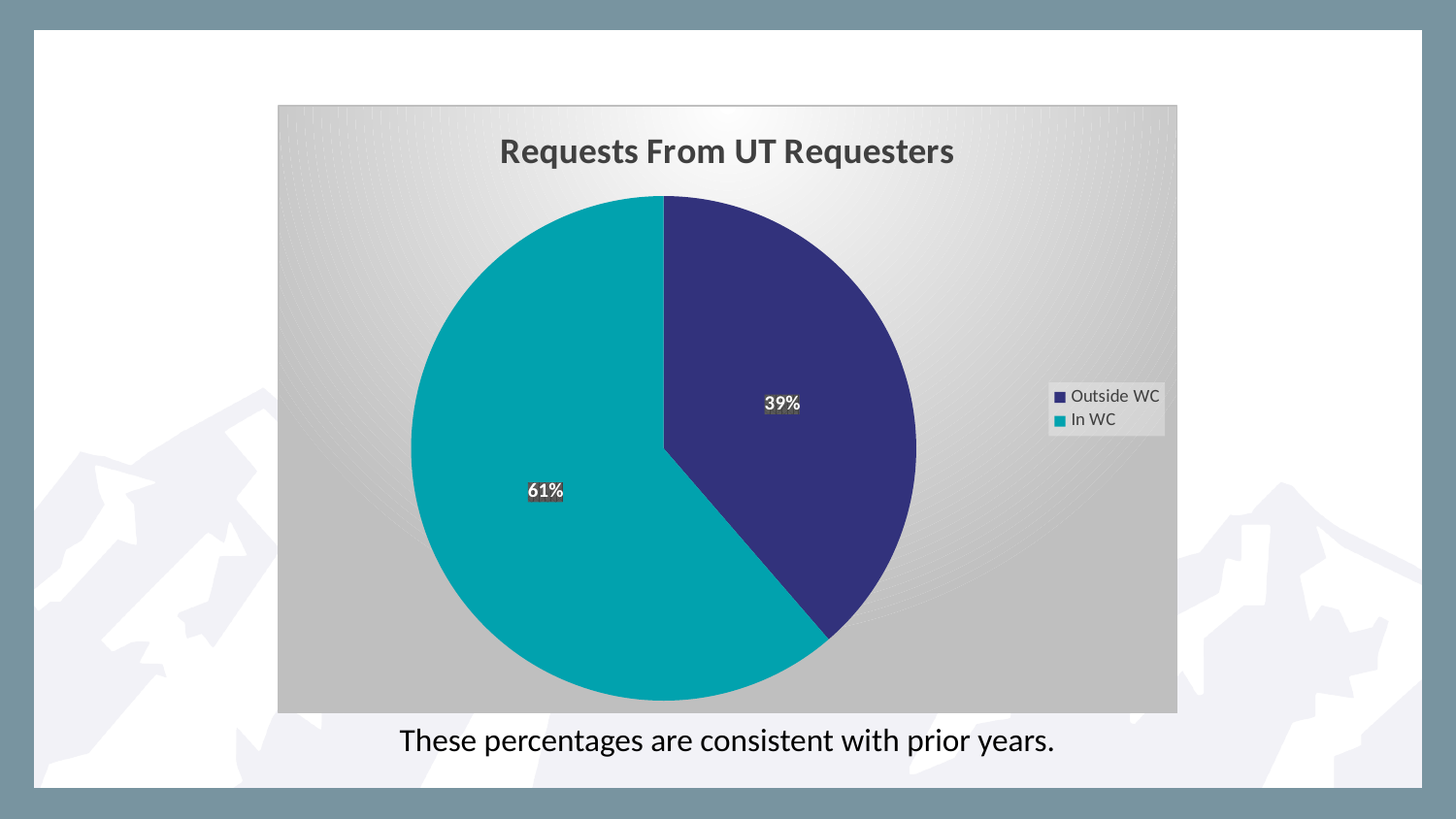
What is the share of the pie for In WC? 61% What kind of chart is shown on the slide? pie chart Which category has the largest share of the pie? In WC How many slices does the pie chart have? 2 How many entries does the legend list? 2 What is the title of the chart? Requests From UT Requesters What percentage of requests are from Outside WC? 39% Which category has the smallest share of the pie? Outside WC What percentage of requests are from In WC? 61% What colour is the slice for Outside WC? dark blue Which is larger, the share for In WC or the share for Outside WC? In WC What is the difference in percentage points between In WC and Outside WC? 22